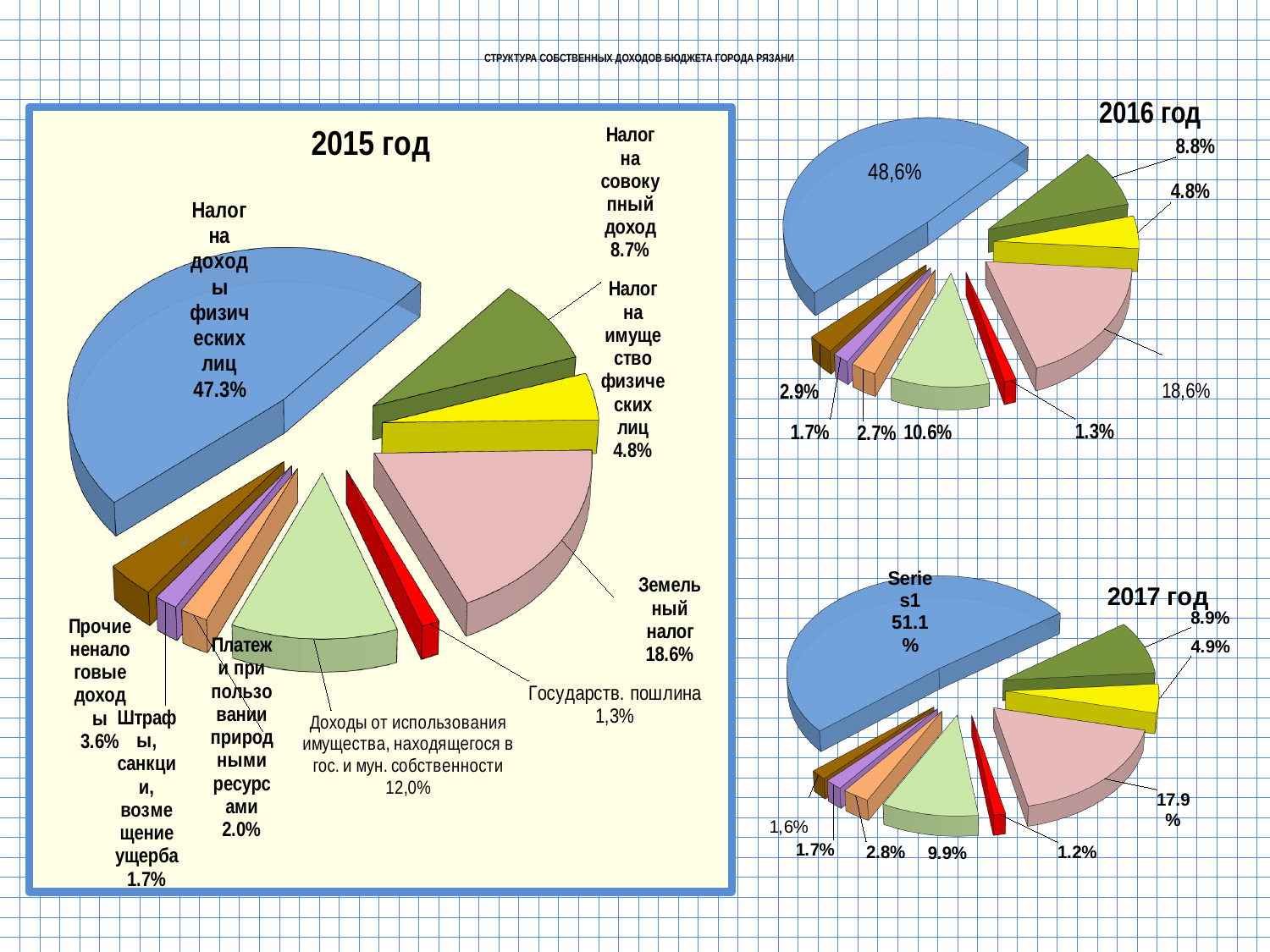
In the 2015 pie chart, what share is shown for Налог на доходы физических лиц? 47.3% In the 2015 pie chart, what share is shown for Доходы от использования имущества, находящегося в гос. и мун. собственности? 12,0% In the 2015 pie chart, which category has the largest share? Налог на доходы физических лиц What type of chart is used for the 2016 год data? Pie chart In the 2015 pie chart, which category has the smallest share? Государств. пошлина How many slices does the 2015 pie chart have? 9 In the 2015 pie chart, what share is shown for Государств. пошлина? 1,3% In the 2015 pie chart, what share is shown for Земельный налог? 18.6% In the 2017 год pie chart, what is the share of the smallest slice? 1.2% In the 2016 год pie chart, what is the share of the largest slice? 48,6% In the 2015 pie chart, which is larger: Прочие неналоговые доходы or Платежи при пользовании природными ресурсами? Прочие неналоговые доходы In the 2015 pie chart, what is the difference between the shares of Налог на совокупный доход and Налог на имущество физических лиц? 3.9%